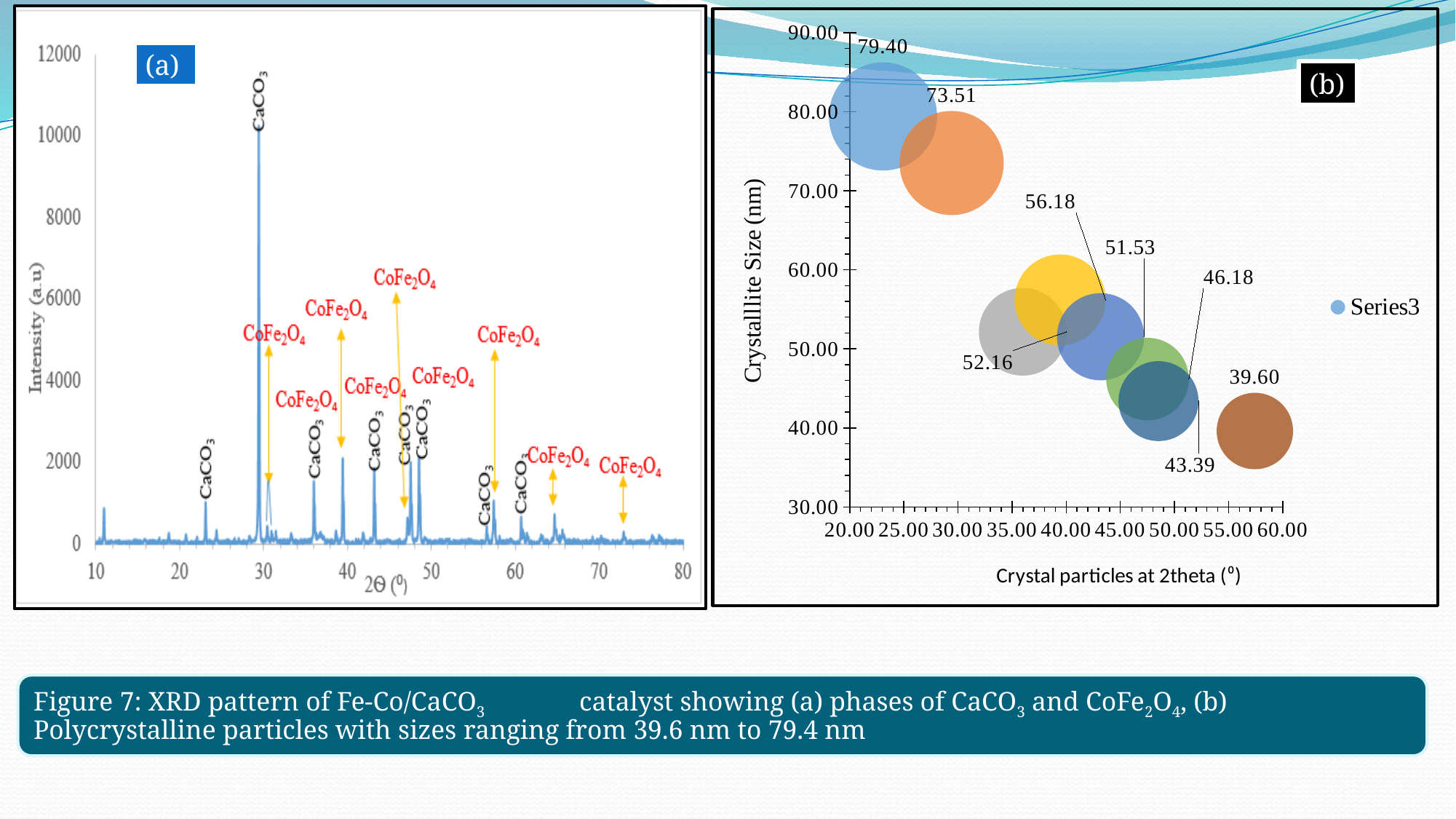
What kind of chart is chart (a) on the left of the slide? line chart What kind of chart is chart (b) on the right of the slide? bubble chart In chart (b), what is the largest labelled crystallite size? 79.40 In chart (b), how many bubbles are plotted? 8 How many series does the legend of chart (b) list? 1 In chart (b), what is the difference between the values labelled 73.51 and 56.18? 17.33 In chart (b), what is the smallest labelled crystallite size? 39.60 In chart (b), do the crystallite sizes rise or fall as the 2theta value increases along the x axis? fall In chart (b), which labelled value is larger, 52.16 or 51.53? 52.16 In chart (b), what is the difference between the largest labelled value (79.40) and the smallest labelled value (39.60)? 39.80 What is the title of the vertical axis in chart (b)? Crystalllite Size (nm) In chart (a), is the intensity of the tallest peak greater or less than 10000? greater